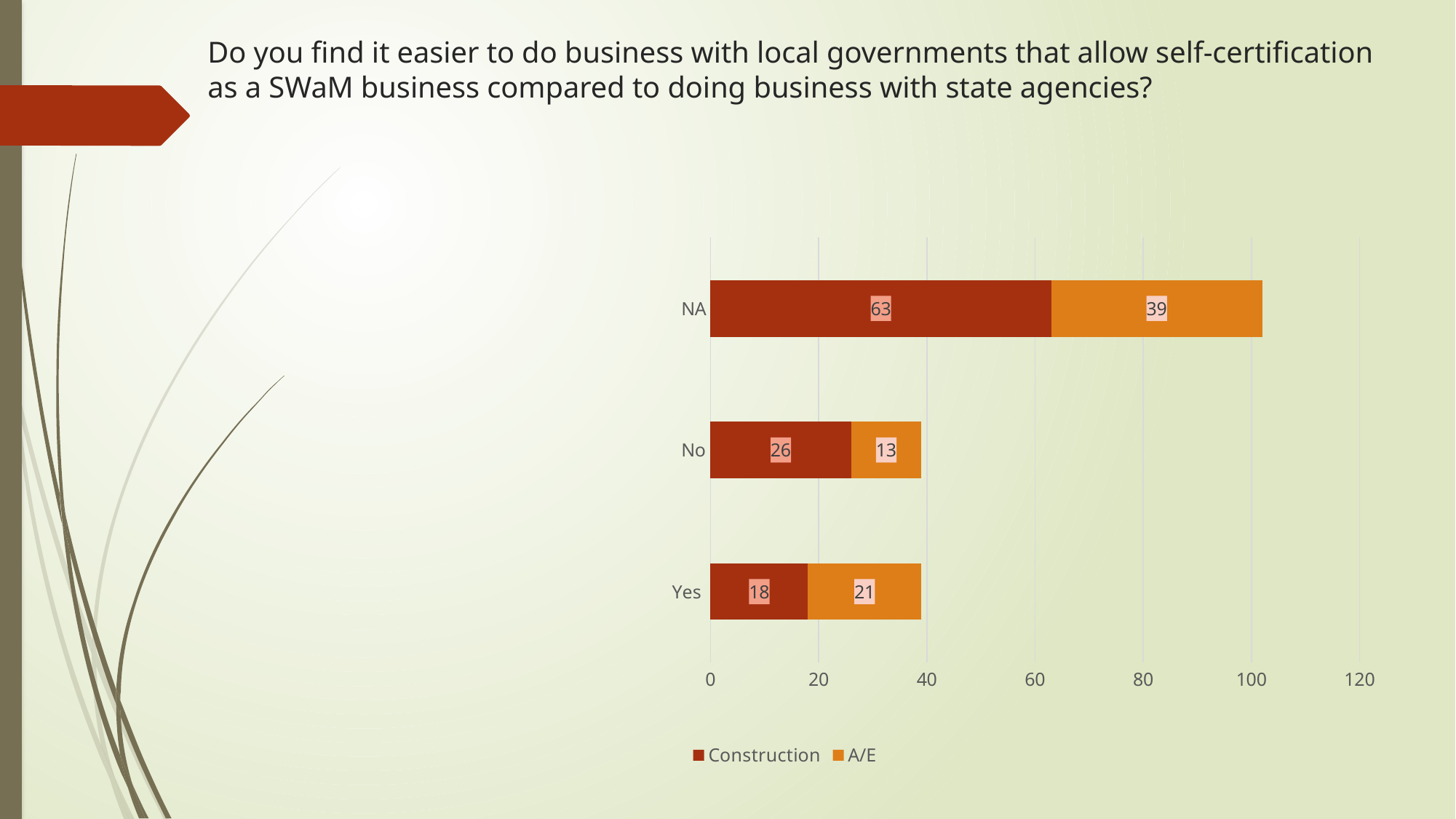
What is the A/E value for the No category? 13 How many series does the legend list? 2 What kind of chart is shown on the slide? Stacked bar chart What is the A/E value for the Yes category? 21 Which category has the lowest A/E value? No Which category has the highest Construction value? NA What is the total of the stacked bar for NA? 102 How many categories are shown on the chart? 3 What is the Construction value for the NA category? 63 What is the difference between the Construction values for NA and No? 37 What is the total of the stacked bar for No? 39 For the Yes category, which is larger: the Construction value or the A/E value? A/E